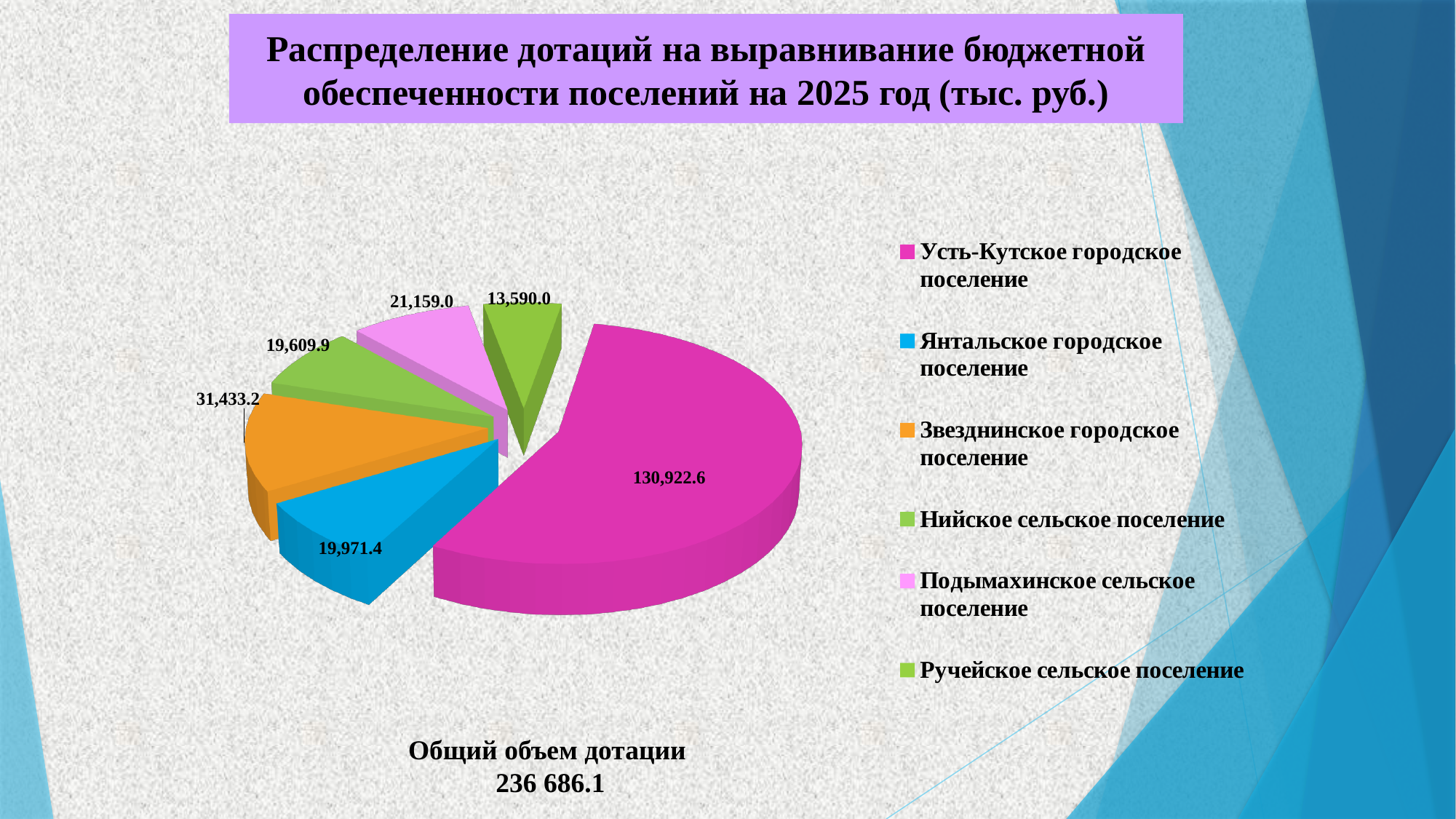
What is the value for Подымахинское сельское поселение? 21,159.0 How many settlements are shown in the pie chart? 6 What is the value for Усть-Кутское городское поселение? 130,922.6 Which is larger: the value for Подымахинское сельское поселение or Нийское сельское поселение? Подымахинское сельское поселение What total subsidy amount is stated below the chart? 236 686.1 What type of chart is shown on the slide? Pie chart What is the value for Янтальское городское поселение? 19,971.4 What is the value for Ручейское сельское поселение? 13,590.0 Which settlement receives the smallest share of the subsidy? Ручейское сельское поселение Which settlement receives the largest share of the subsidy? Усть-Кутское городское поселение What is the value for Звезднинское городское поселение? 31,433.2 What is the difference between the values for Усть-Кутское городское поселение and Звезднинское городское поселение? 99,489.4